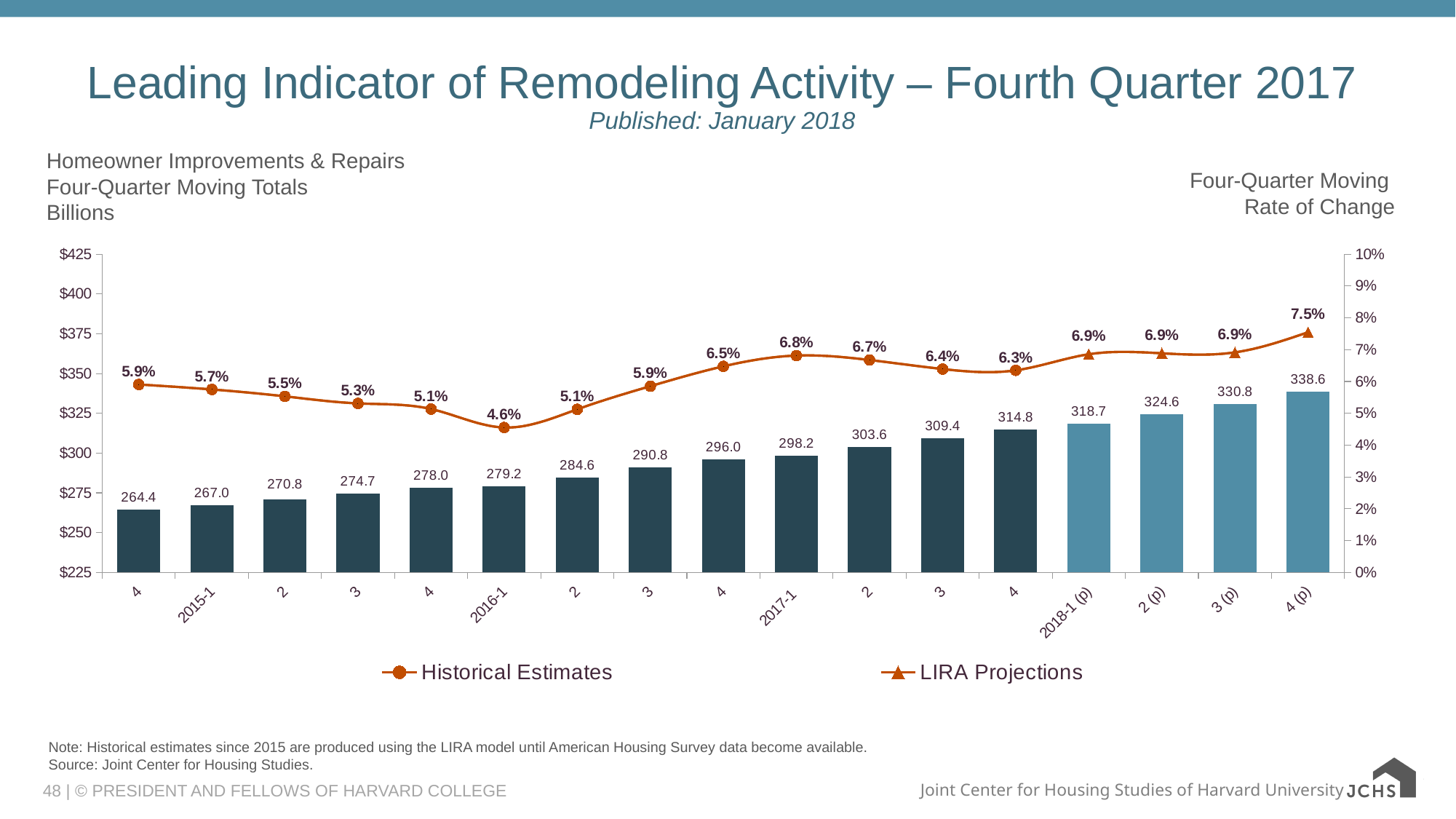
What kind of chart is shown? Combination bar and line chart How many series does the legend list? 2 Which quarter has the highest four-quarter moving total? 4 (p) of 2018 Do the four-quarter moving totals rise or fall from left to right across the chart? Rise What is the four-quarter moving rate of change for 2017-1? 6.8% What is the four-quarter moving total for 2016-1? 279.2 Which quarter has the lowest four-quarter moving rate of change? 2016-1 Which has the higher rate of change, the second quarter of 2017 or the third quarter of 2017? Second quarter of 2017 What is the difference between the four-quarter moving totals for 2018-1 (p) and the fourth quarter of 2017? 3.9 What is the four-quarter moving total for the third quarter of 2015? 274.7 How many bars are plotted on the chart? 17 What are the two entries in the chart legend? Historical Estimates and LIRA Projections